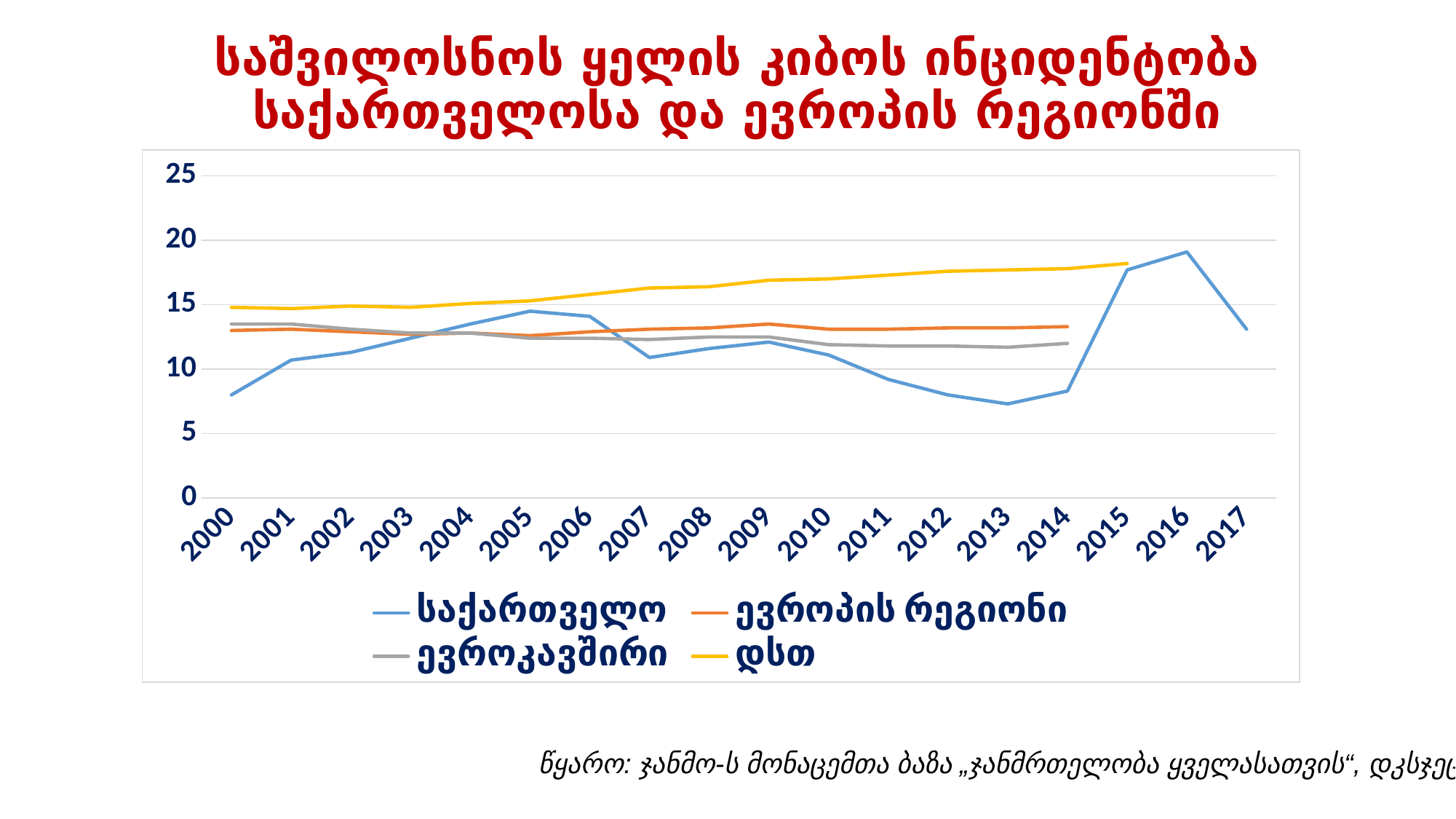
How many series does the legend list? 4 How many years are shown along the x axis? 18 In which year does the საქართველო line reach its highest value? 2016 In which year does the საქართველო line reach its lowest value? 2013 Which series has the highest value in 2010? დსთ Is the value for დსთ in 2015 greater or less than 15? greater What kind of chart is shown on the slide? line chart Does the დსთ line generally rise or fall from 2000 to 2015? rise Is the value for საქართველო in 2016 greater or less than 15? greater Is the value for ევროკავშირი in 2014 greater or less than 10? greater In 2013, which is larger: the value for საქართველო or for ევროპის რეგიონი? ევროპის რეგიონი